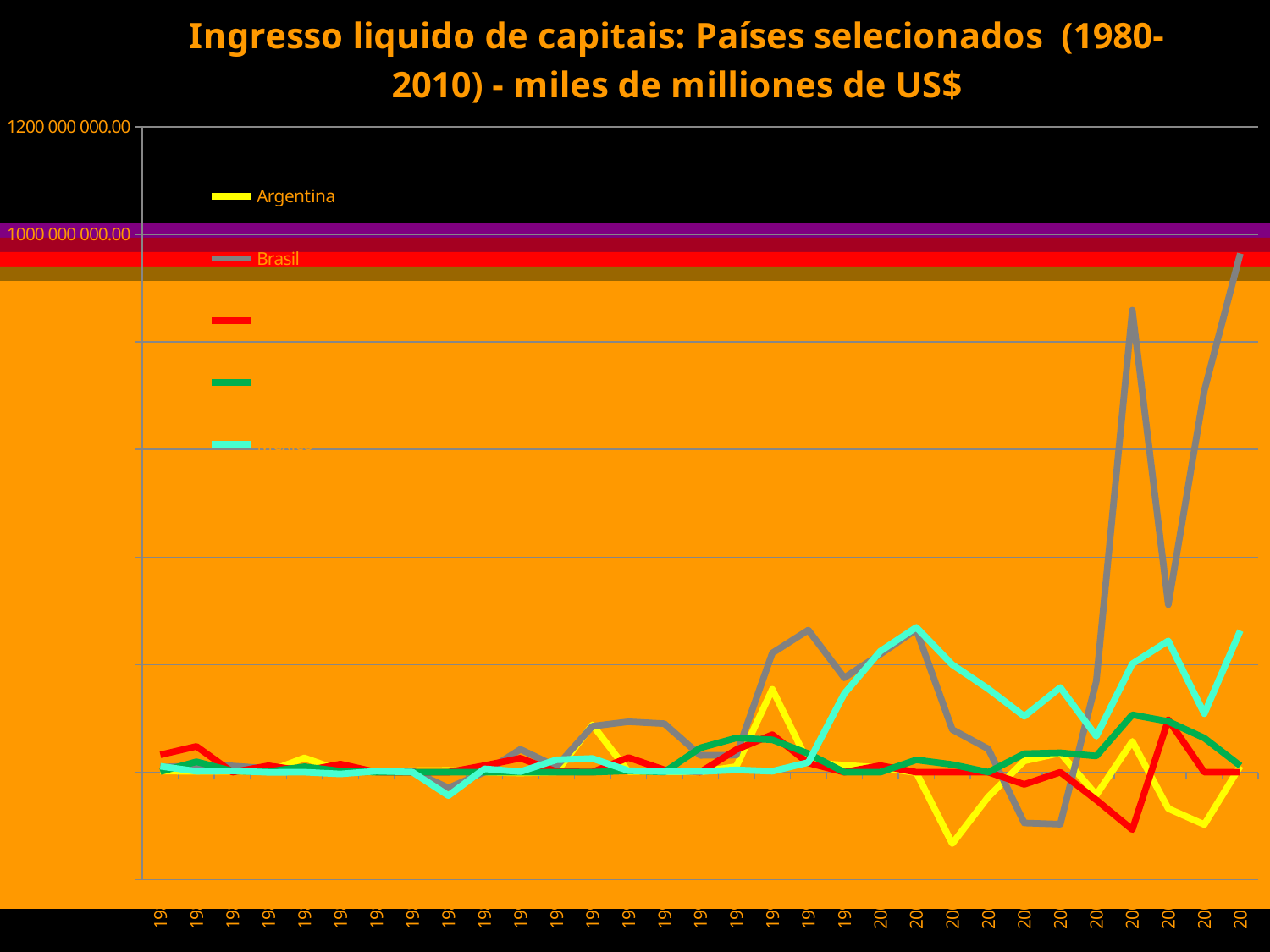
At the last year shown, which is larger, the value for Brasil or the value for Argentina? Brasil How many series (lines) does the legend list? 5 What kind of chart is shown on the slide? line chart What is the title of the chart? Ingresso liquido de capitais: Países selecionados (1980-2010) - miles de milliones de US$ What colour is the line for Brasil? gray Is the highest value reached by Argentina greater or less than 1000 000 000.00? less Which series reaches the highest value on the chart? Brasil Is the highest value reached by Brasil greater or less than 1200 000 000.00? less Does the Brasil line overall rise or fall from the start to the end of the period? rise